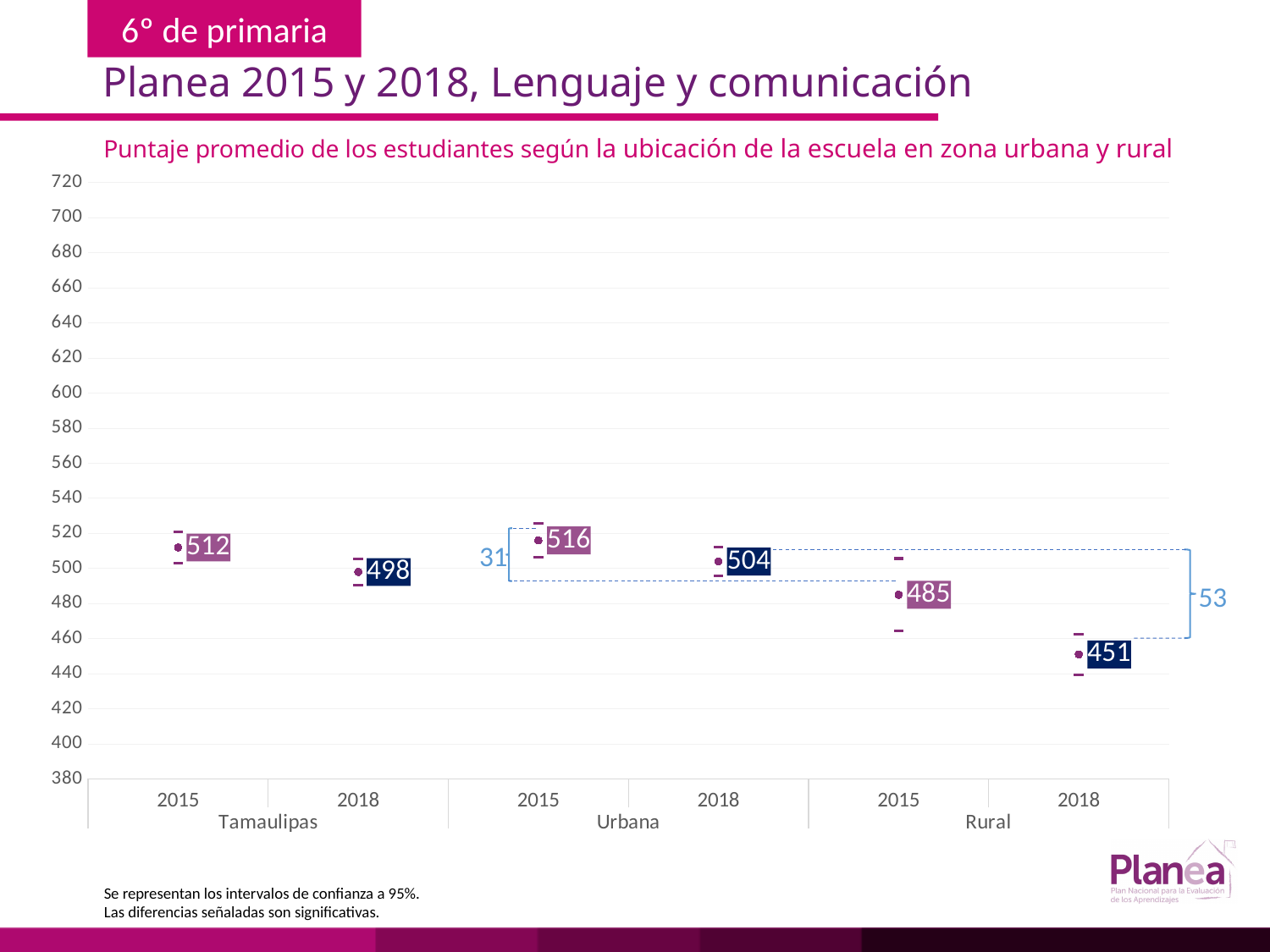
How many data points are plotted on the chart? 6 Which is larger, the Rural score in 2015 or the Rural score in 2018? Rural 2015 What is the average score for Rural schools in 2018? 451 By how many points did the Tamaulipas average score change from 2015 to 2018? 14 What confidence level do the intervals shown on the chart represent? 95% What is the difference between the Urbana and Rural average scores in 2018? 53 What is the average score for Tamaulipas in 2018? 498 Which group and year has the lowest average score? Rural 2018 What is the average score for Urbana schools in 2015? 516 Which group and year has the highest average score? Urbana 2015 Did the average scores rise or fall from 2015 to 2018 in each group? Fall What is the average score for Tamaulipas in 2015? 512